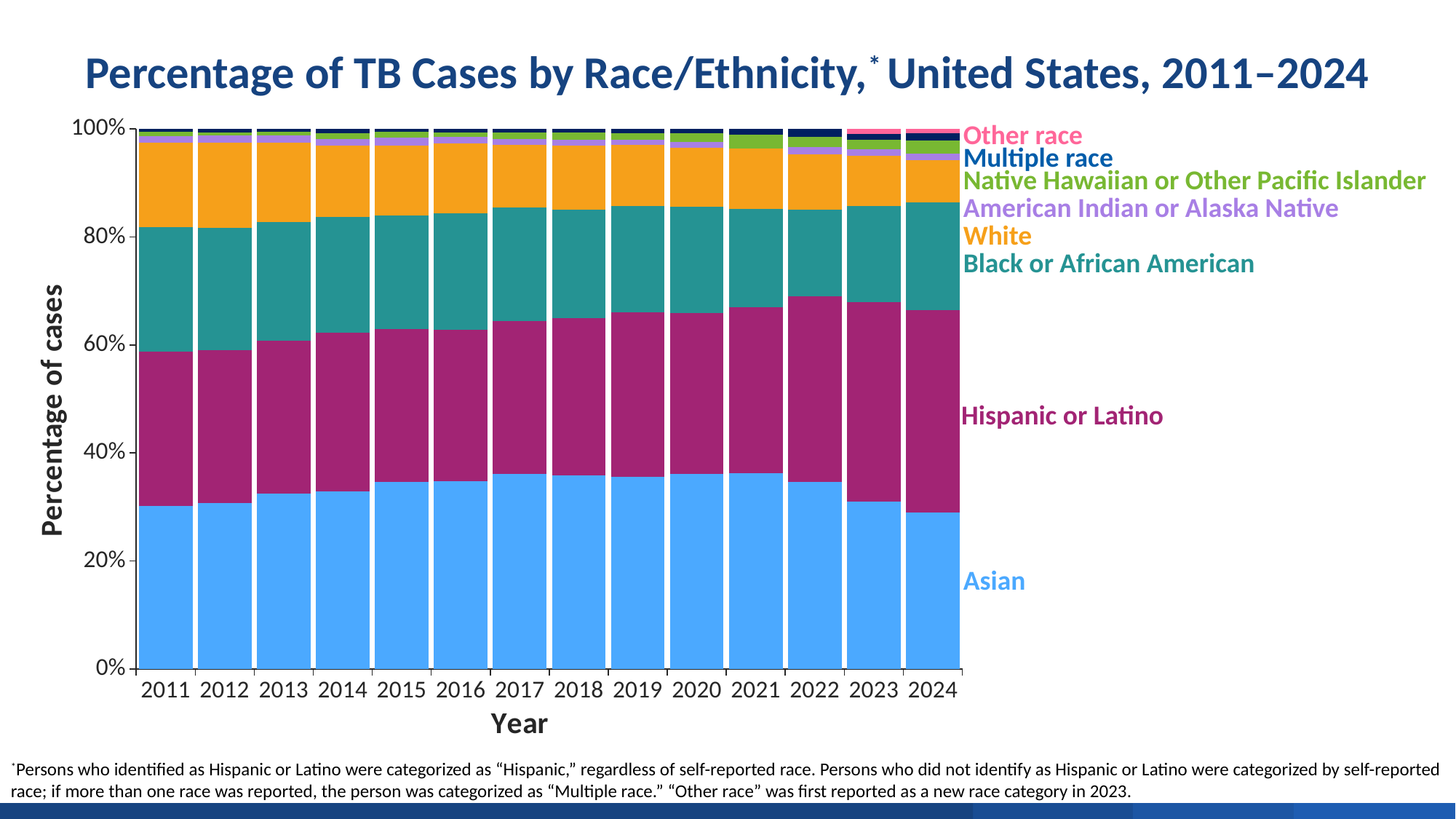
Is the White share of TB cases in 2011 greater or less than 20%? less In which year does the Other race category first appear in the chart? 2023 Does the Asian share of TB cases rise or fall from 2021 to 2024? fall Which race/ethnicity category forms the bottom segment of each bar? Asian Does the Asian share of TB cases rise or fall from 2011 to 2021? rise Is the combined share of Asian and Hispanic or Latino cases in 2022 greater or less than 60%? greater How many years are shown along the x axis? 14 How many race/ethnicity categories does the legend list? 8 Is the Asian share of TB cases in 2021 greater or less than 30%? greater What kind of chart is shown on the slide? Stacked bar chart In 2024, which is larger: the Hispanic or Latino share or the Asian share? Hispanic or Latino